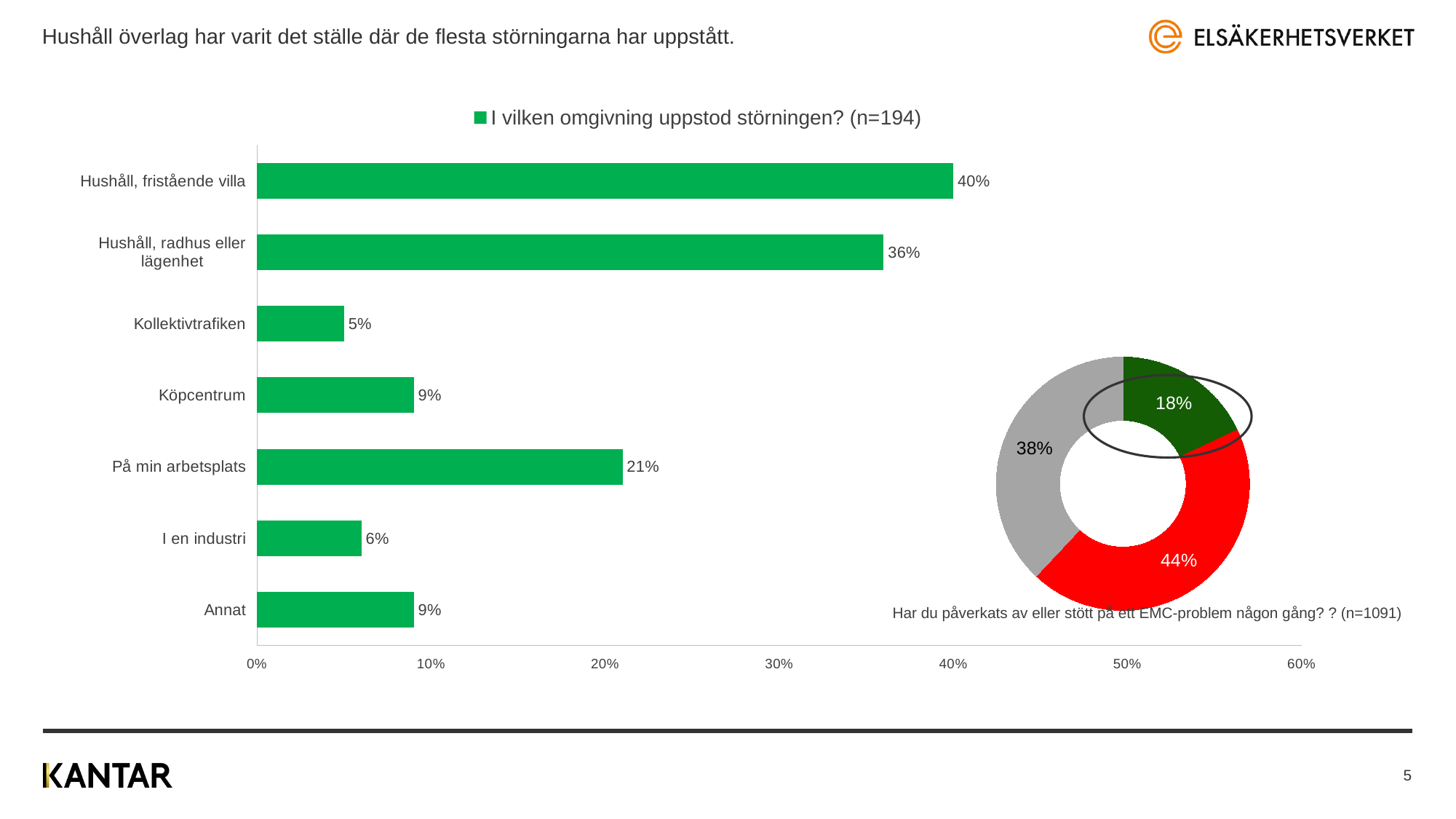
In the bar chart 'I vilken omgivning uppstod störningen?', what is the sample size shown in the title? n=194 In the bar chart 'I vilken omgivning uppstod störningen?', what is the value for På min arbetsplats? 21% In the bar chart 'I vilken omgivning uppstod störningen?', which category has the lowest value? Kollektivtrafiken In the bar chart 'I vilken omgivning uppstod störningen?', which is larger: På min arbetsplats or Köpcentrum? På min arbetsplats In the donut chart on the right, what percentage is shown on the dark green slice? 18% In the bar chart 'I vilken omgivning uppstod störningen?', which category has the highest value? Hushåll, fristående villa In the bar chart 'I vilken omgivning uppstod störningen?', what is the difference between Hushåll, fristående villa and Hushåll, radhus eller lägenhet? 4% In the bar chart 'I vilken omgivning uppstod störningen?', what is the value for Hushåll, fristående villa? 40% What kind of chart is the chart titled 'I vilken omgivning uppstod störningen?'? Bar chart In the bar chart 'I vilken omgivning uppstod störningen?', what is the value for Kollektivtrafiken? 5% In the bar chart 'I vilken omgivning uppstod störningen?', how many categories are shown? 7 In the donut chart on the right, what percentage is shown on the red slice? 44%